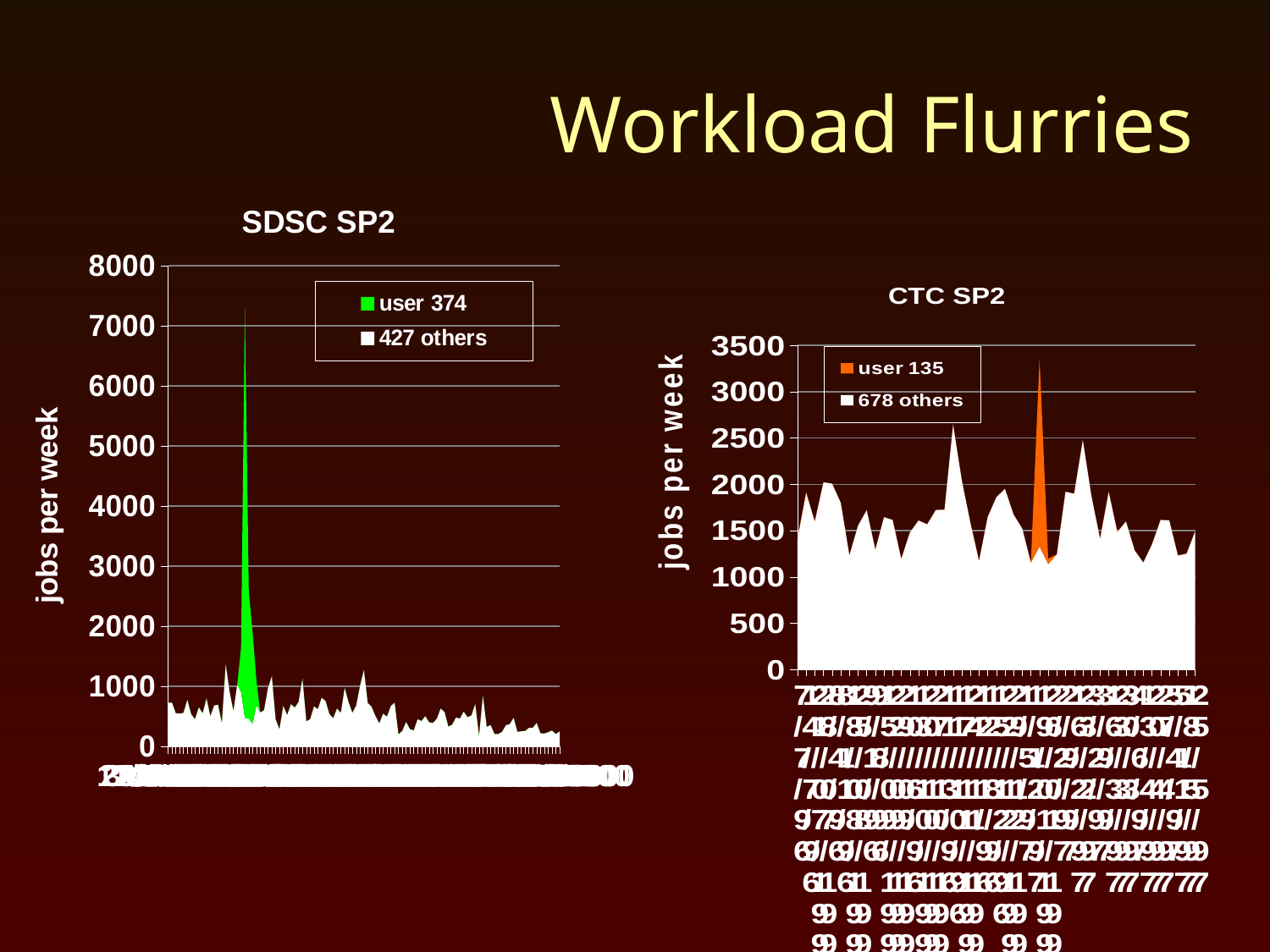
What is the y-axis label of the CTC SP2 chart? jobs per week What kind of chart is the SDSC SP2 chart? area chart How many series does the legend of the CTC SP2 chart list? 2 In the SDSC SP2 chart, is the highest value for 427 others greater or less than 2000? less In the CTC SP2 chart, is the highest value for 678 others greater or less than 3000? less In the SDSC SP2 chart, is the peak value for user 374 greater or less than 6000? greater Which chart shows the higher peak in jobs per week, SDSC SP2 or CTC SP2? SDSC SP2 What kind of chart is the CTC SP2 chart? area chart What are the two legend entries of the SDSC SP2 chart? user 374 and 427 others How many series does the legend of the SDSC SP2 chart list? 2